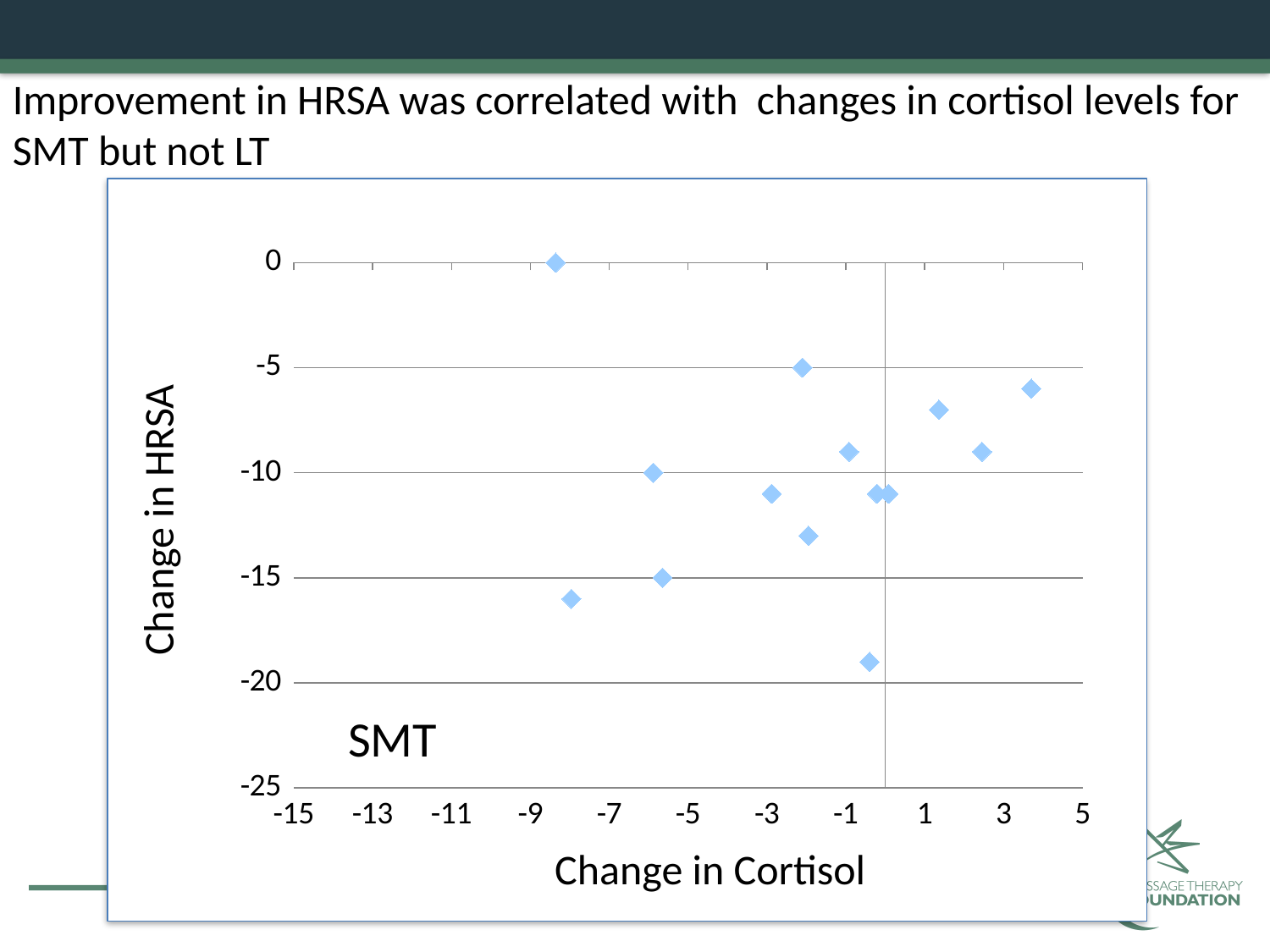
Is the Change in Cortisol of the highest point (at Change in HRSA = 0) greater or less than -7? less What is the Change in HRSA value of the highest point on the chart? 0 Is the Change in HRSA of the rightmost point on the chart greater or less than -10? greater Is the Change in Cortisol of the lowest point on the chart greater or less than -3? greater What kind of chart is shown on the slide? scatter plot What is the label of the x axis? Change in Cortisol What is the label of the y axis? Change in HRSA As Change in Cortisol increases along the x axis, do the Change in HRSA values generally rise or fall? rise What is the minimum value shown on the x axis? -15 How many data points are plotted in the chart? 14